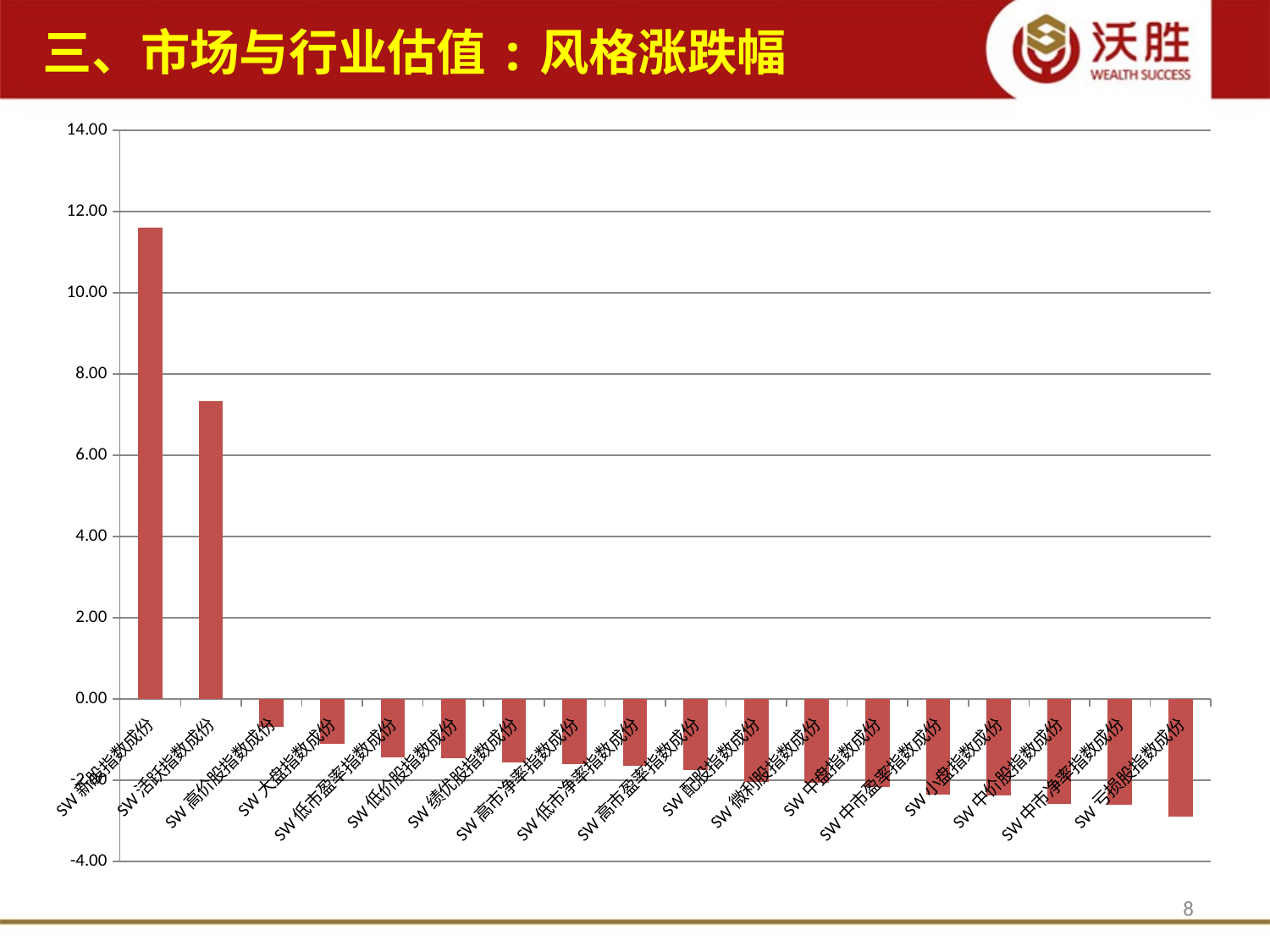
Which category has the lowest value in the chart? SW 亏损股指数成份 What is the title of the slide containing the chart? 三、市场与行业估值：风格涨跌幅 Is the value for SW 亏损股指数成份 greater or less than -2.00? less Which category has the highest value in the chart? SW 新股指数成份 Is the value for SW 新股指数成份 greater or less than 10.00? greater Is the value for SW 活跃指数成份 greater or less than 8.00? less Do the values generally rise or fall moving from left to right along the x axis? fall What kind of chart is shown on the slide? bar chart Which is larger, the value for SW 新股指数成份 or the value for SW 活跃指数成份? SW 新股指数成份 How many categories (bars) are plotted in the chart? 18 How many categories have a positive value (bar above 0.00)? 2